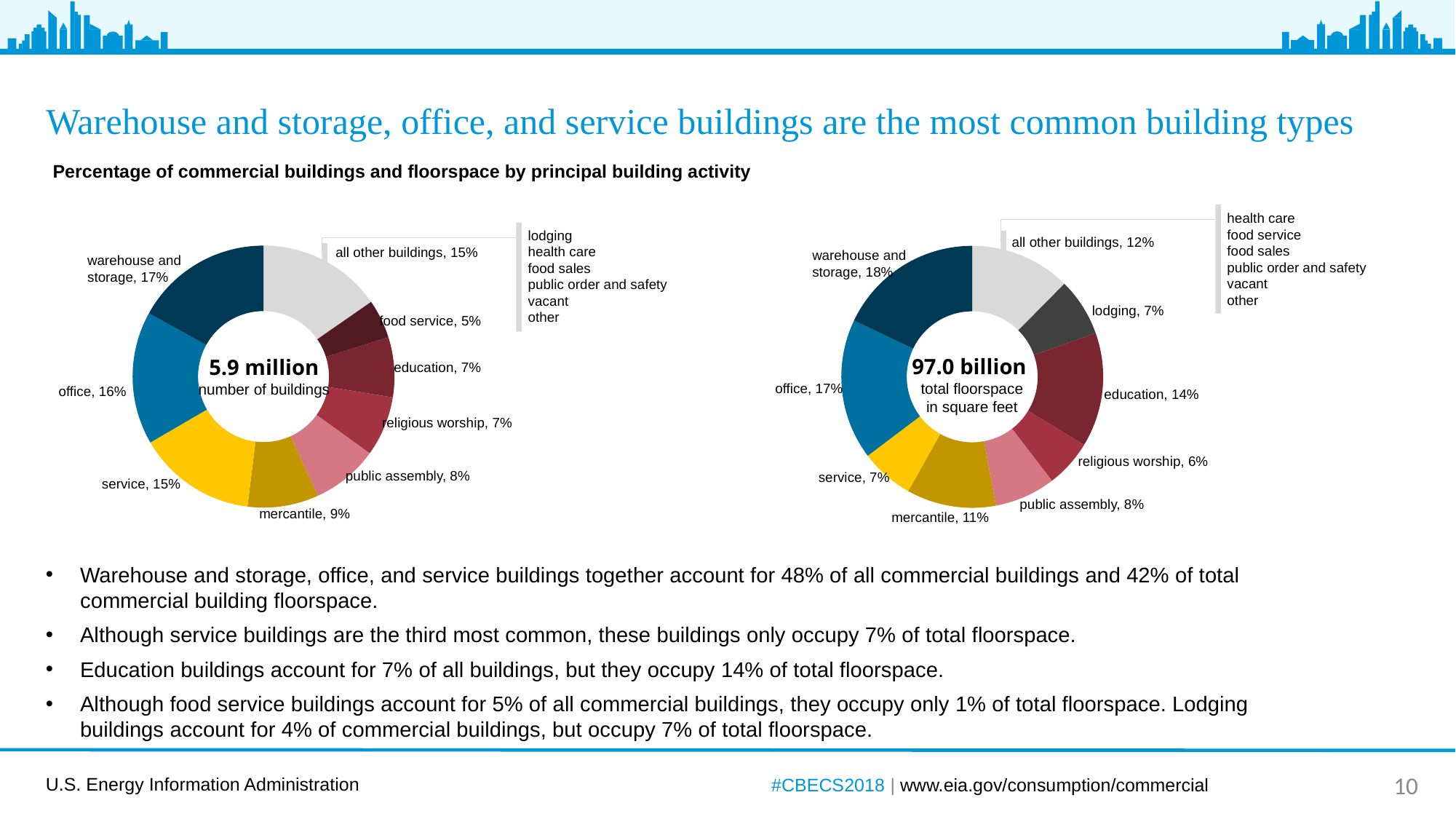
In the right chart (total floorspace), which labelled building type has the smallest share? religious worship In the right chart (total floorspace), what percentage of floorspace is occupied by education buildings? 14% In the left chart (number of buildings), what percentage of commercial buildings are warehouse and storage buildings? 17% In the left chart (number of buildings), what percentage is labelled for mercantile? 9% How many labelled slices does the left chart (number of buildings) have? 9 What is the difference in percentage points between the service share in the left chart (15%) and the service share in the right chart (7%)? 8 percentage points What total value is shown in the centre of the left chart? 5.9 million In the left chart (number of buildings), which labelled building type has the smallest share? food service In the right chart (total floorspace), which is larger: the share for mercantile or the share for lodging? mercantile In the right chart (total floorspace), which building type has the largest share? warehouse and storage What kind of chart is used on this slide? Donut (pie) chart What total value is shown in the centre of the right chart? 97.0 billion